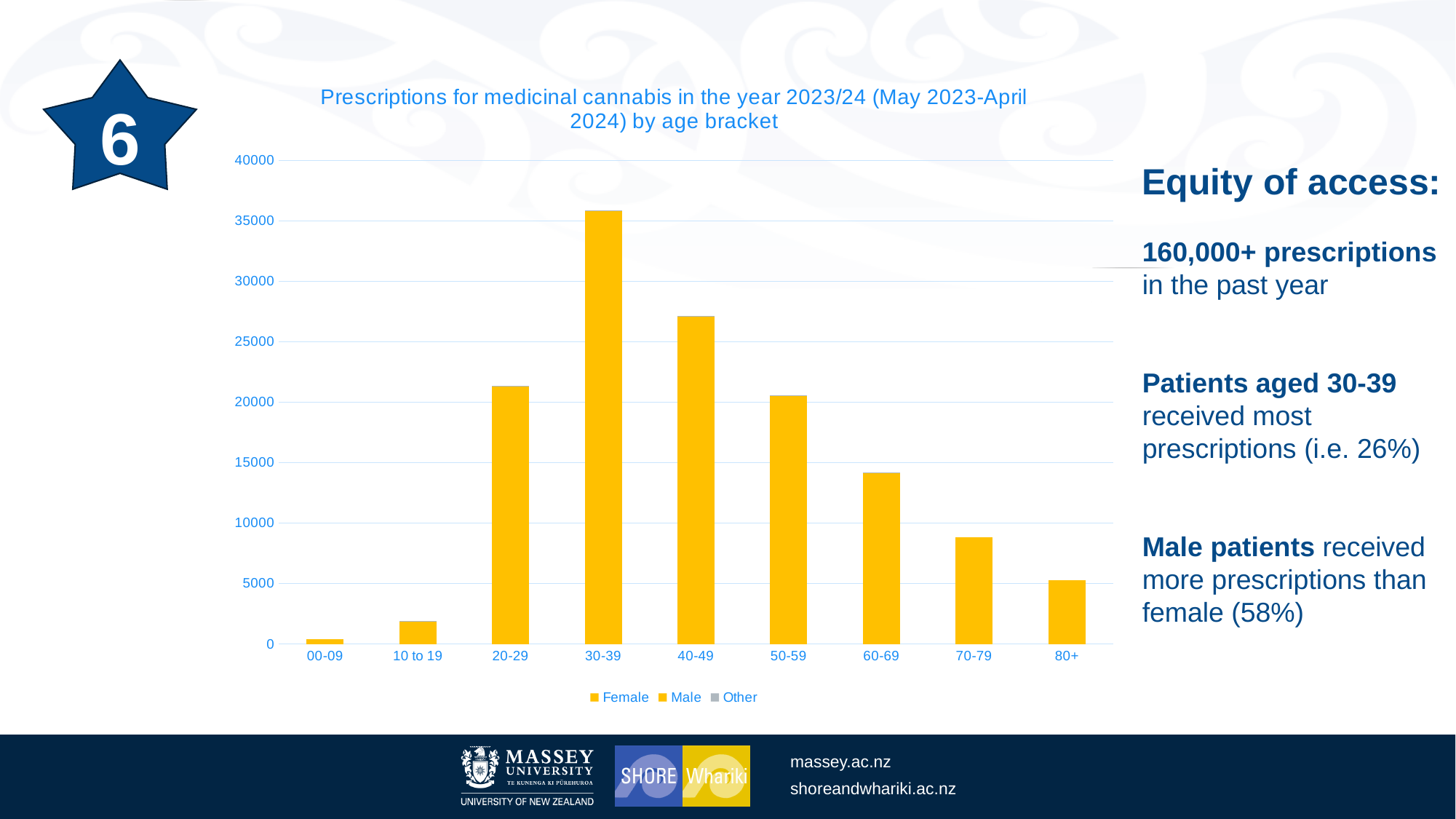
How many age brackets are shown on the x axis of the chart? 9 Is the value for the 30-39 age bracket greater or less than 35000? greater Is the value for the 40-49 age bracket greater or less than 25000? greater What kind of chart is shown on the slide? bar chart Which age bracket has more prescriptions, 40-49 or 50-59? 40-49 Which age bracket has the lowest number of prescriptions? 00-09 Is the value for the 70-79 age bracket greater or less than 10000? less How many series does the chart's legend list? 3 Do the values rise or fall along the x axis from the 30-39 bracket to the 80+ bracket? fall What are the three series named in the chart's legend? Female, Male, Other Which age bracket has the highest number of prescriptions? 30-39